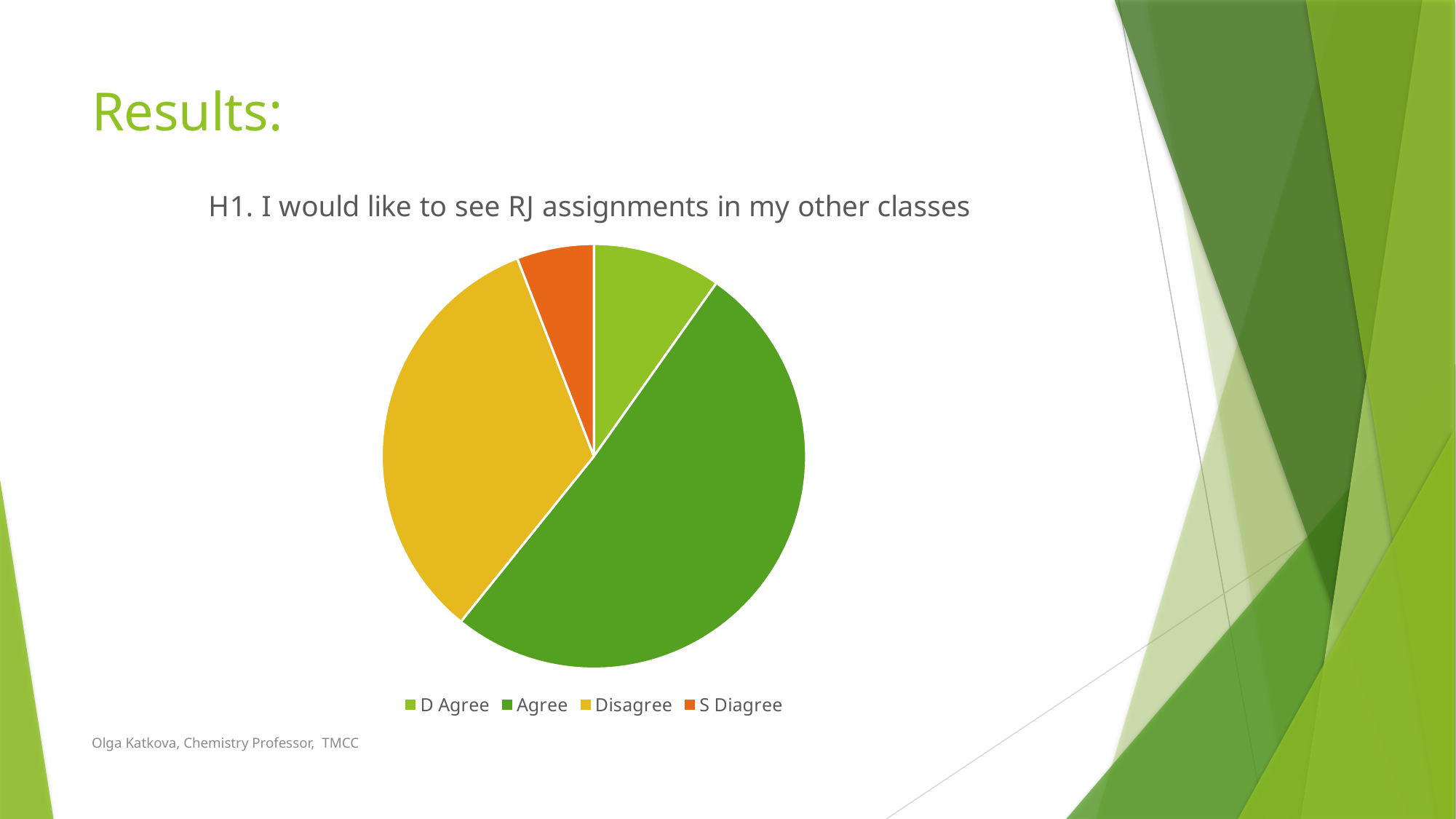
Which category has the smallest slice of the pie? S Diagree What kind of chart is shown on the slide? pie chart What colour is the Disagree slice in the pie chart? yellow Which category has the largest slice of the pie? Agree What is the title of the pie chart? H1. I would like to see RJ assignments in my other classes Which slice is larger, Agree or Disagree? Agree Which slice is larger, Disagree or D Agree? Disagree How many categories does the pie chart have? 4 Which category is the second largest slice of the pie? Disagree Which slice is larger, D Agree or S Diagree? D Agree